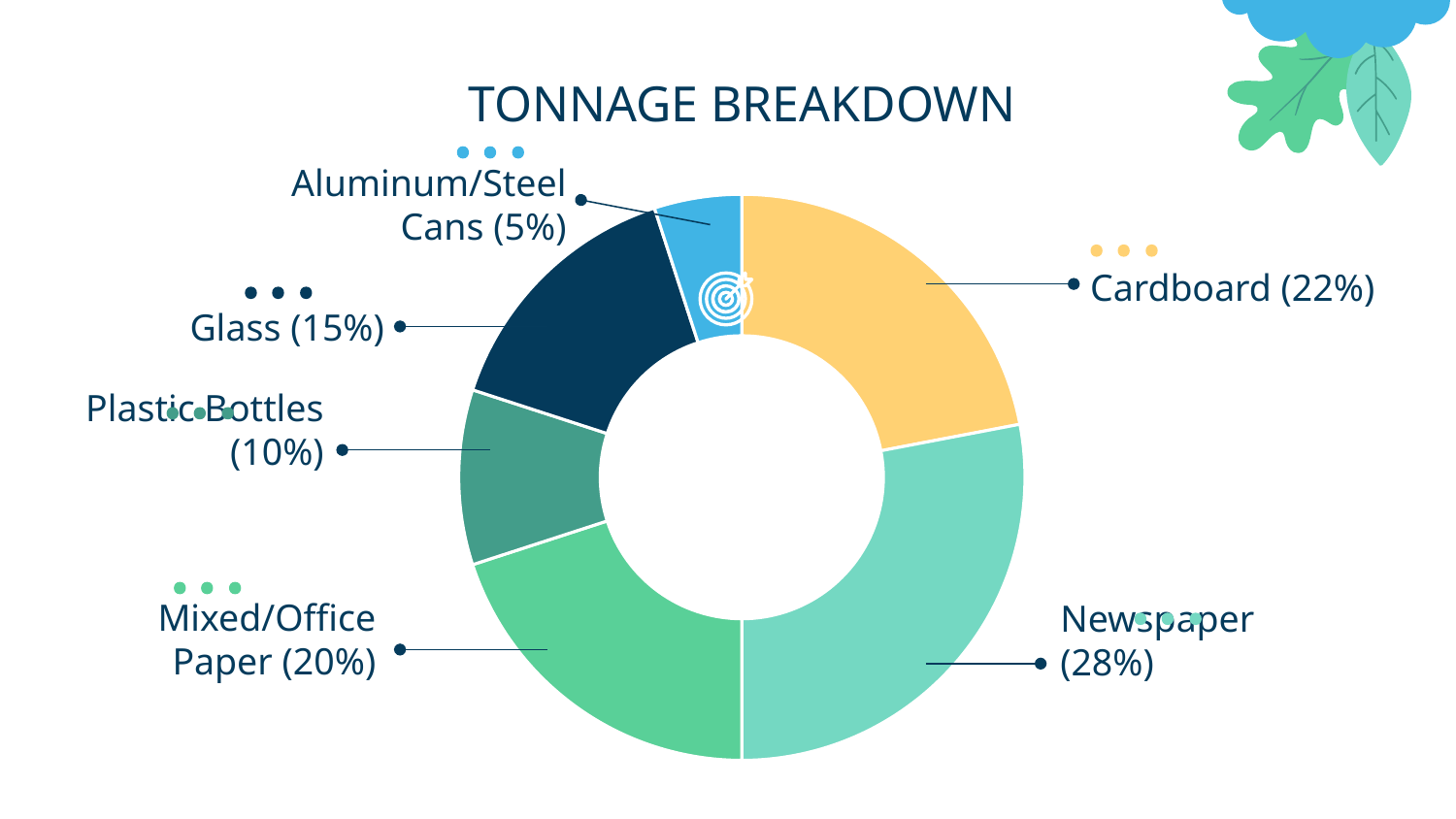
Which category has the smallest share? Aluminum/Steel Cans What kind of chart is shown on the slide? Pie chart (doughnut) What is the title of the chart? TONNAGE BREAKDOWN What percentage does Cardboard account for? 22% What percentage does Newspaper account for? 28% What colour is the Cardboard slice? Yellow Which category has the largest share? Newspaper How many categories are shown in the chart? 6 What percentage do Aluminum/Steel Cans account for? 5% What is the difference in percentage points between Newspaper and Mixed/Office Paper? 8 What percentage does Glass account for? 15% Which is larger, Cardboard or Glass? Cardboard